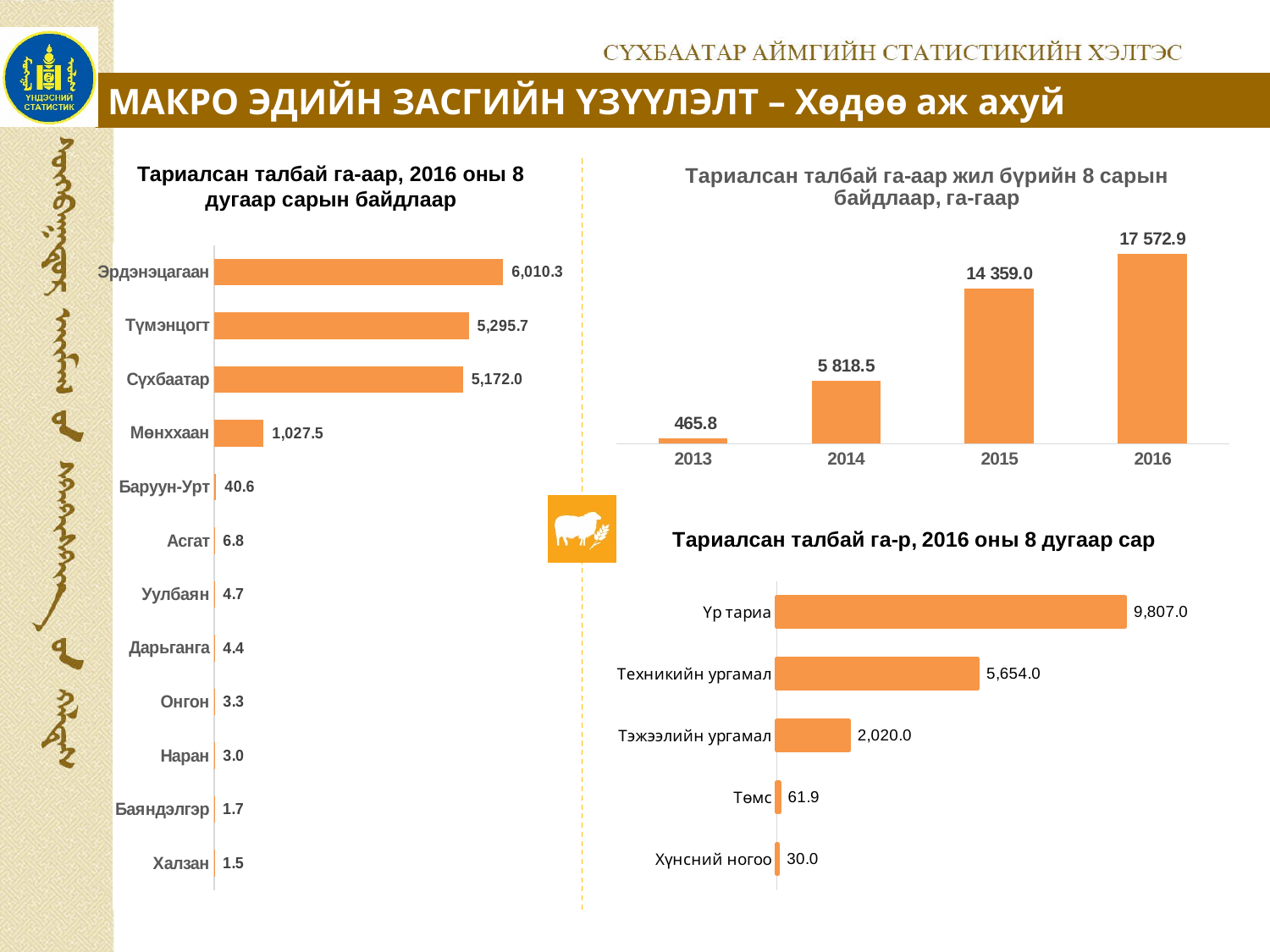
In the top-right chart 'Тариалсан талбай га-аар жил бүрийн 8 сарын байдлаар, га-гаар', what is the value for 2015? 14 359.0 In the top-right chart 'Тариалсан талбай га-аар жил бүрийн 8 сарын байдлаар, га-гаар', do the values rise or fall from 2013 to 2016? rise In the left chart 'Тариалсан талбай га-аар, 2016 оны 8 дугаар сарын байдлаар', what is the difference between Эрдэнэцагаан and Сүхбаатар? 838.3 In the bottom-right chart 'Тариалсан талбай га-р, 2016 оны 8 дугаар сар', how many categories are shown? 5 In the left chart 'Тариалсан талбай га-аар, 2016 оны 8 дугаар сарын байдлаар', what is the value for Түмэнцогт? 5,295.7 In the left chart 'Тариалсан талбай га-аар, 2016 оны 8 дугаар сарын байдлаар', which category has the lowest value? Халзан In the bottom-right chart 'Тариалсан талбай га-р, 2016 оны 8 дугаар сар', which is larger, Төмс or Хүнсний ногоо? Төмс In the top-right chart 'Тариалсан талбай га-аар жил бүрийн 8 сарын байдлаар, га-гаар', which year has the lowest value? 2013 What type of chart is the top-right chart 'Тариалсан талбай га-аар жил бүрийн 8 сарын байдлаар, га-гаар'? bar chart In the bottom-right chart 'Тариалсан талбай га-р, 2016 оны 8 дугаар сар', what is the value for Техникийн ургамал? 5,654.0 In the left chart 'Тариалсан талбай га-аар, 2016 оны 8 дугаар сарын байдлаар', how many categories are shown? 12 In the left chart 'Тариалсан талбай га-аар, 2016 оны 8 дугаар сарын байдлаар', which category has the highest value? Эрдэнэцагаан